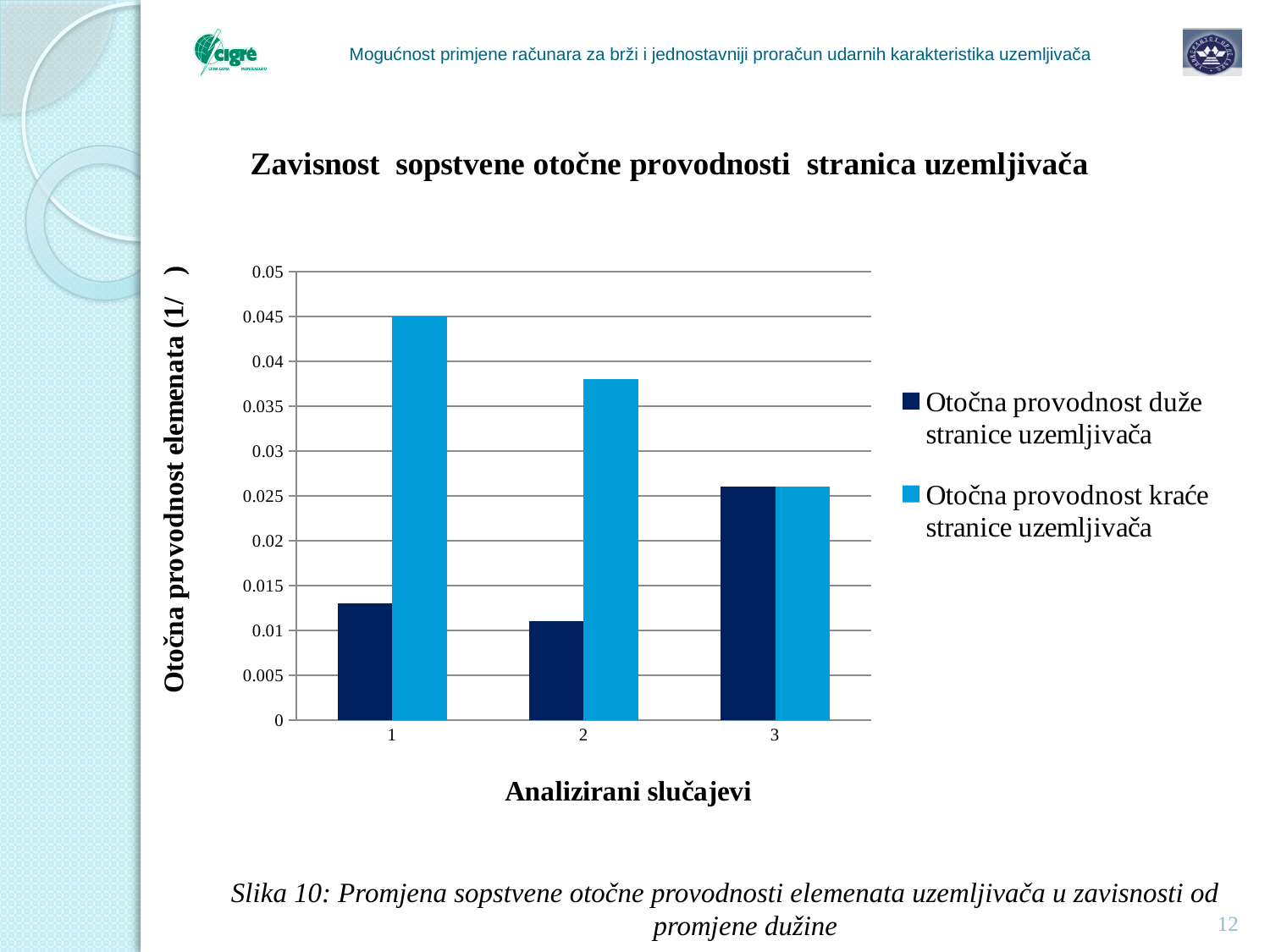
Which category has the highest value for Otočna provodnost kraće stranice uzemljivača? 1 How many series does the legend list? 2 What is the x-axis title of the chart? Analizirani slučajevi What kind of chart is shown on the slide? bar chart Is the value for Otočna provodnost duže stranice uzemljivača in category 3 greater or less than 0.02? greater Which category has the lowest value for Otočna provodnost duže stranice uzemljivača? 2 In category 1, which series has the larger value: Otočna provodnost duže stranice uzemljivača or Otočna provodnost kraće stranice uzemljivača? Otočna provodnost kraće stranice uzemljivača Is the value for Otočna provodnost duže stranice uzemljivača in category 1 greater or less than 0.015? less Do the values for Otočna provodnost kraće stranice uzemljivača rise or fall from category 1 to category 3? fall Is the value for Otočna provodnost kraće stranice uzemljivača in category 2 greater or less than 0.035? greater How many categories are shown on the x axis? 3 What is the title of the chart? Zavisnost sopstvene otočne provodnosti stranica uzemljivača